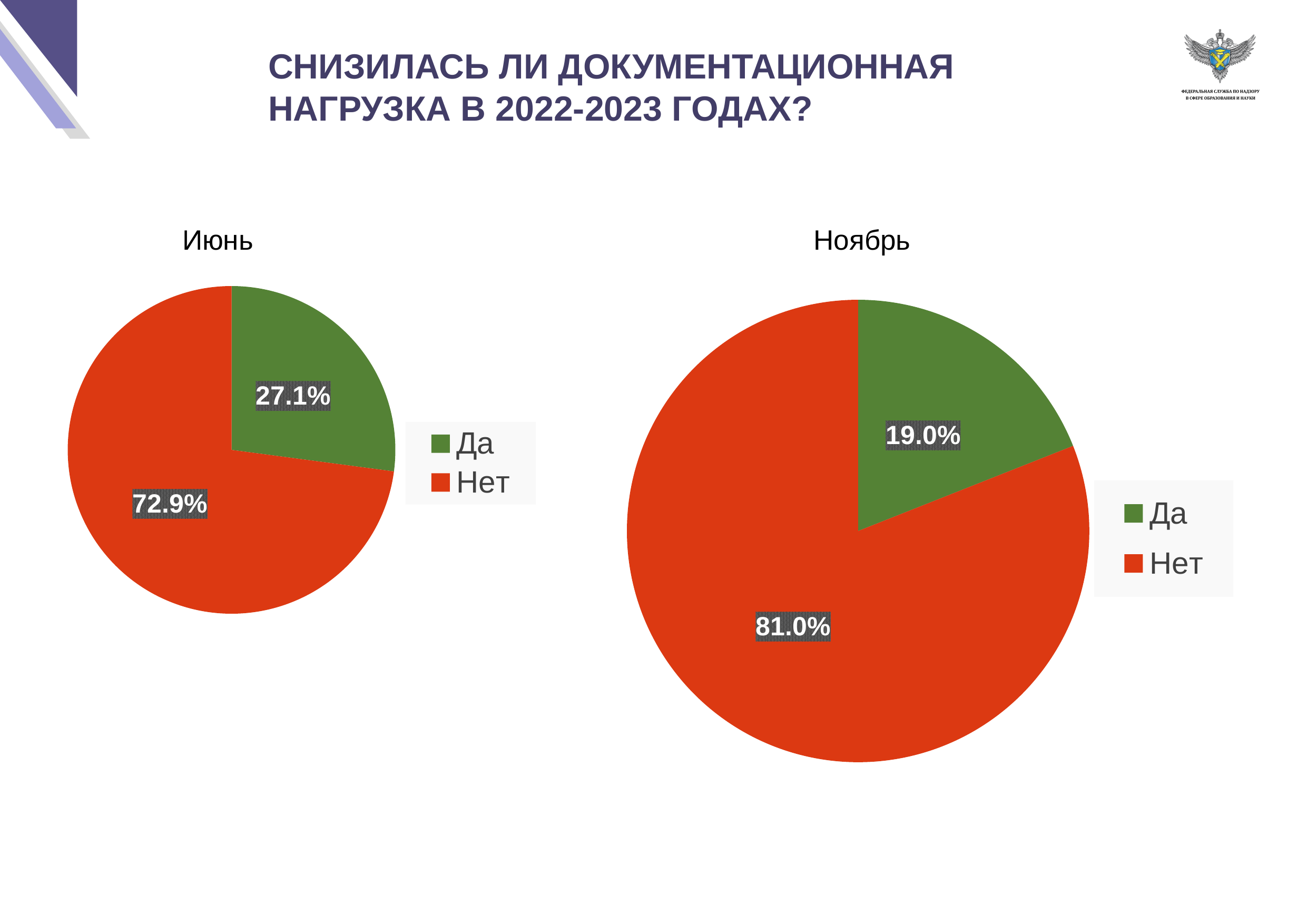
In the "Ноябрь" chart, which category has the smallest slice? Да Which is larger: the "Да" value in the "Июнь" chart or the "Да" value in the "Ноябрь" chart? Июнь In the "Ноябрь" chart, what is the difference between the "Нет" and "Да" values? 62.0% How many categories does the legend of the "Июнь" chart list? 2 In the "Ноябрь" chart, what is the value for "Да"? 19.0% In the "Ноябрь" chart, what colour is the "Нет" slice? Red In the "Ноябрь" chart, what is the value for "Нет"? 81.0% In the "Июнь" chart, which category has the largest slice? Нет In the "Июнь" chart, what is the value for "Да"? 27.1% What type of chart is the "Ноябрь" chart? Pie chart In the "Июнь" chart, what is the difference between the "Нет" and "Да" values? 45.8% In the "Июнь" chart, what is the value for "Нет"? 72.9%